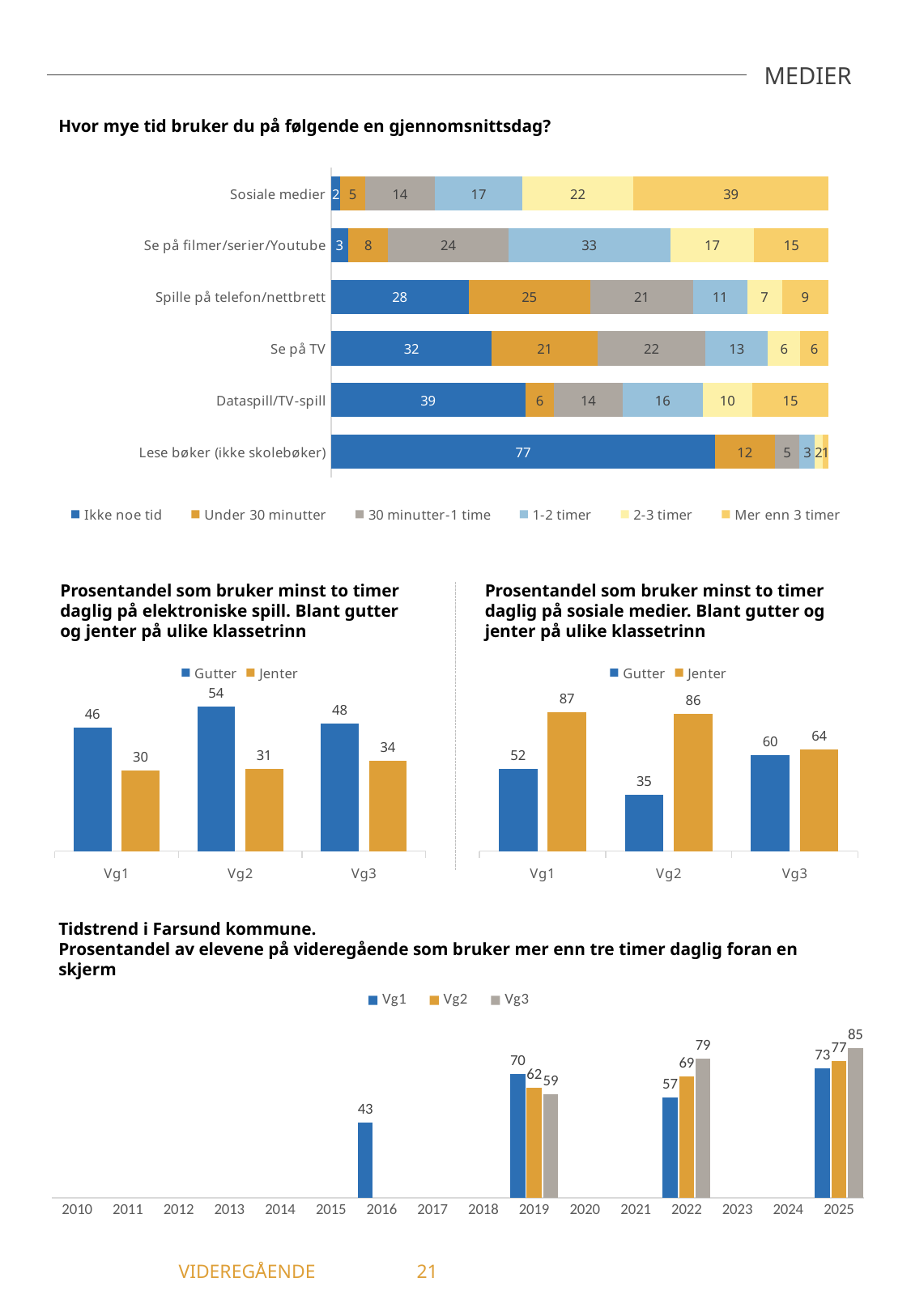
In the top chart 'Hvor mye tid bruker du på følgende en gjennomsnittsdag?', how many series does the legend list? 6 In the chart 'Prosentandel som bruker minst to timer daglig på sosiale medier', which group has the lowest value across all class levels? Gutter at Vg2 In the chart 'Tidstrend i Farsund kommune', does the Vg3 value rise or fall from 2019 to 2025? Rise In the top chart 'Hvor mye tid bruker du på følgende en gjennomsnittsdag?', what is the value for 'Ikke noe tid' for Lese bøker (ikke skolebøker)? 77 In the chart 'Tidstrend i Farsund kommune', what is the value for Vg3 in 2025? 85 In the chart 'Prosentandel som bruker minst to timer daglig på elektroniske spill', what is the value for Gutter at Vg2? 54 In the chart 'Prosentandel som bruker minst to timer daglig på sosiale medier', which is larger at Vg3, Gutter or Jenter? Jenter In the chart 'Tidstrend i Farsund kommune', what kind of chart is it? Bar chart In the chart 'Prosentandel som bruker minst to timer daglig på elektroniske spill', what is the difference between Gutter and Jenter at Vg1? 16 In the top chart 'Hvor mye tid bruker du på følgende en gjennomsnittsdag?', how many activity categories are shown? 6 In the top chart 'Hvor mye tid bruker du på følgende en gjennomsnittsdag?', what is the value for 'Mer enn 3 timer' for Sosiale medier? 39 In the top chart 'Hvor mye tid bruker du på følgende en gjennomsnittsdag?', which category has the highest 'Ikke noe tid' value? Lese bøker (ikke skolebøker)